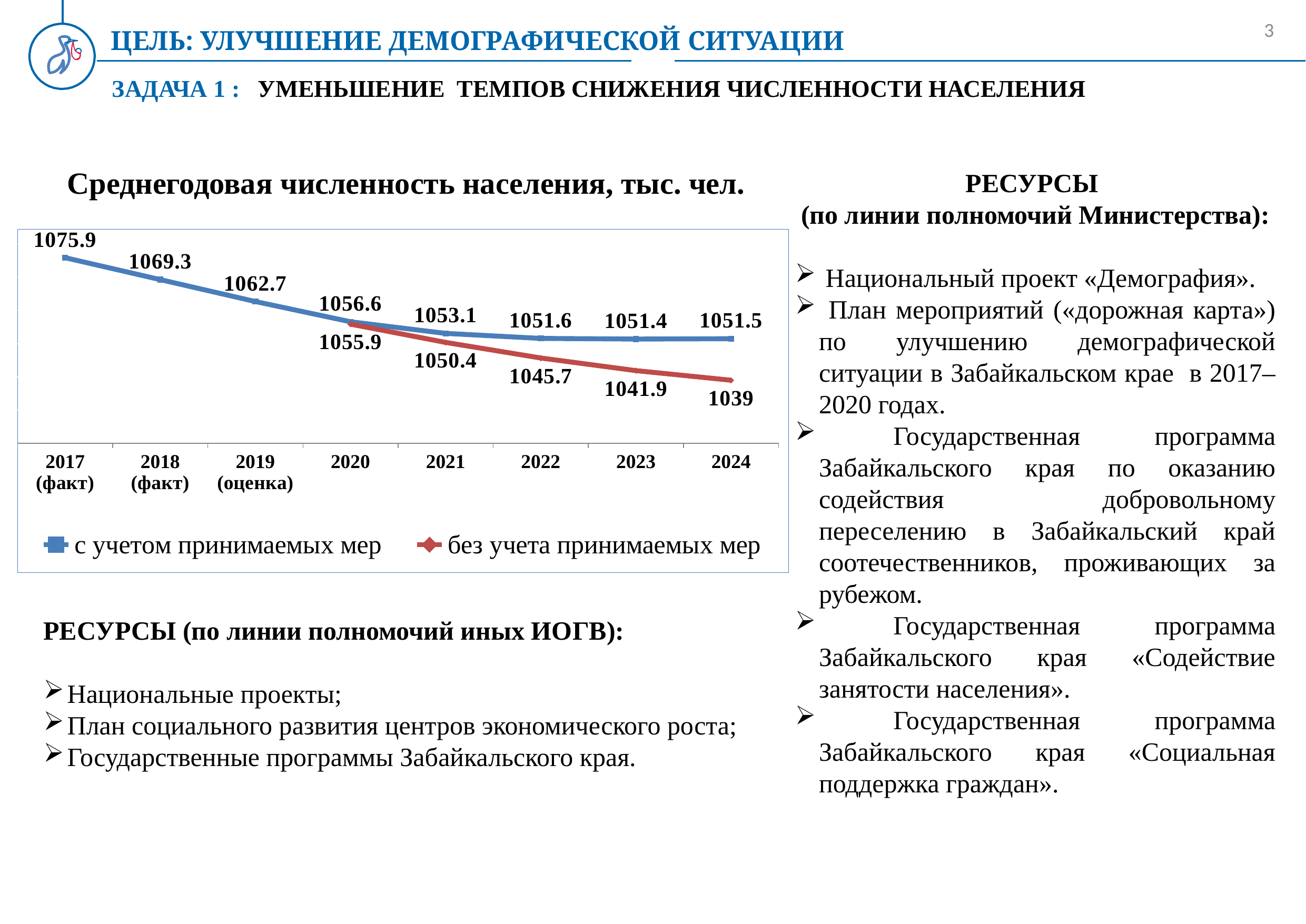
In which year does the series «без учета принимаемых мер» reach its lowest value? 2024 How many series does the chart legend list? 2 How many years are shown on the x axis of the chart? 8 What is the title of the chart? Среднегодовая численность населения, тыс. чел. What is the value of the series «без учета принимаемых мер» for 2024? 1039 What is the value of the series «с учетом принимаемых мер» for 2022? 1051.6 What is the value of the series «с учетом принимаемых мер» for 2017 (факт)? 1075.9 What type of chart is shown on the slide? Line chart Which series has the larger value in 2023: «с учетом принимаемых мер» or «без учета принимаемых мер»? с учетом принимаемых мер What is the value of the series «без учета принимаемых мер» for 2021? 1050.4 What is the difference between the two series in 2024 (1051.5 vs 1039)? 12.5 In which year does the series «с учетом принимаемых мер» reach its highest value? 2017 (факт)